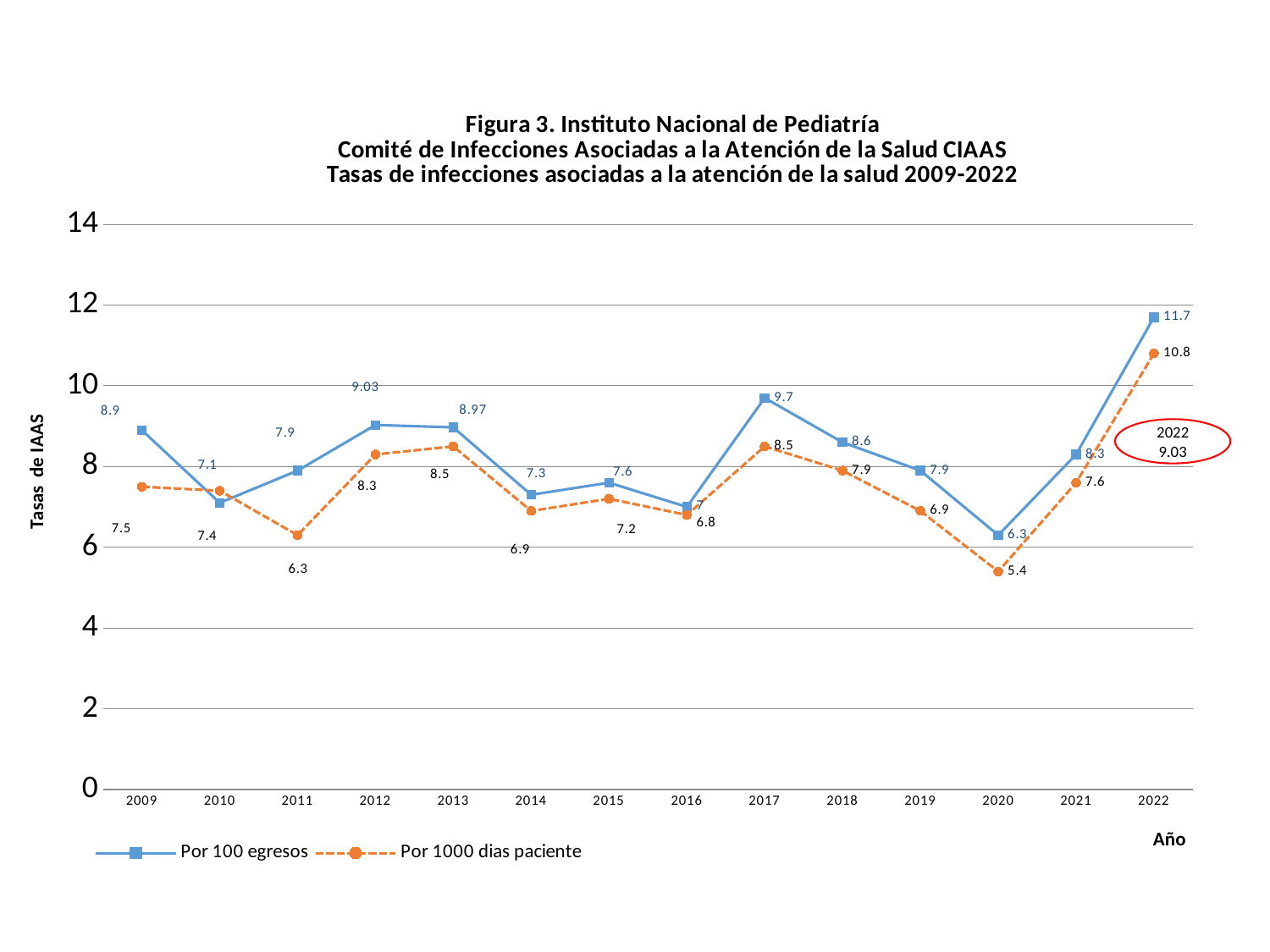
What is the difference between the 'Por 100 egresos' and 'Por 1000 dias paciente' values in 2022? 0.9 In 2010, which series has the larger value, 'Por 100 egresos' or 'Por 1000 dias paciente'? Por 1000 dias paciente Does the 'Por 100 egresos' series rise or fall from 2020 to 2022? Rise In which year is the 'Por 1000 dias paciente' rate lowest? 2020 What is the value of the 'Por 100 egresos' series in 2012? 9.03 How many years are plotted on the x axis? 14 What are the two series named in the legend? Por 100 egresos; Por 1000 dias paciente In which year is the 'Por 100 egresos' rate highest? 2022 What is the value of the 'Por 1000 dias paciente' series in 2020? 5.4 What kind of chart is shown on the slide? Line chart What is the value of the 'Por 100 egresos' series in 2017? 9.7 How many series does the legend list? 2